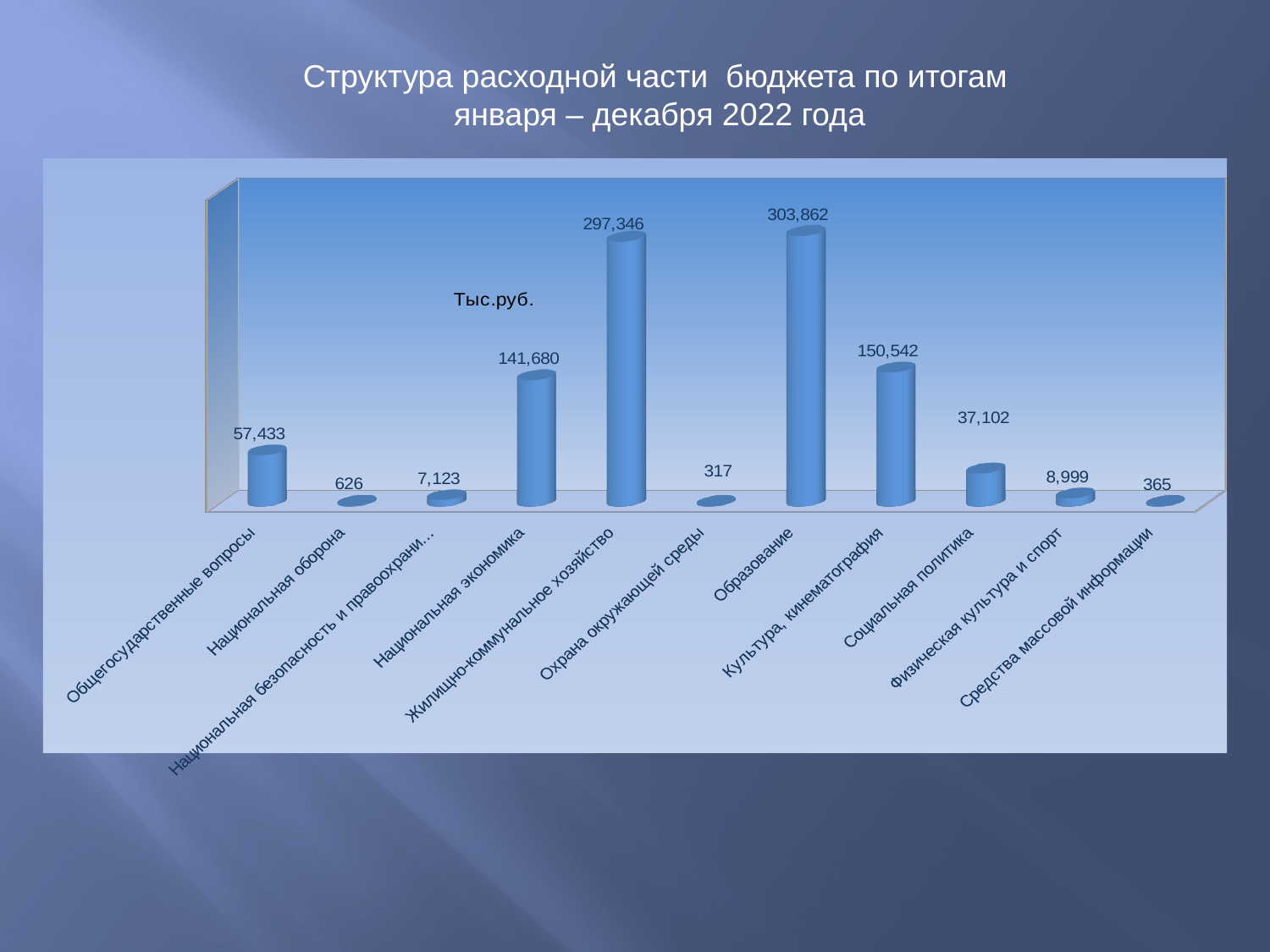
What is the difference between the values for Образование and Жилищно-коммунальное хозяйство? 6,516 Which is larger, the value for Общегосударственные вопросы or the value for Социальная политика? Общегосударственные вопросы What is the value for Национальная оборона? 626 Which category has the highest value? Образование What is the difference between the values for Культура, кинематография and Национальная экономика? 8,862 What kind of chart is shown on the slide? Bar chart What is the value for Социальная политика? 37,102 What unit is indicated on the chart? Тыс.руб. What is the value for Образование? 303,862 What is the value for Жилищно-коммунальное хозяйство? 297,346 How many categories are shown in the chart? 11 Which category has the lowest value? Охрана окружающей среды